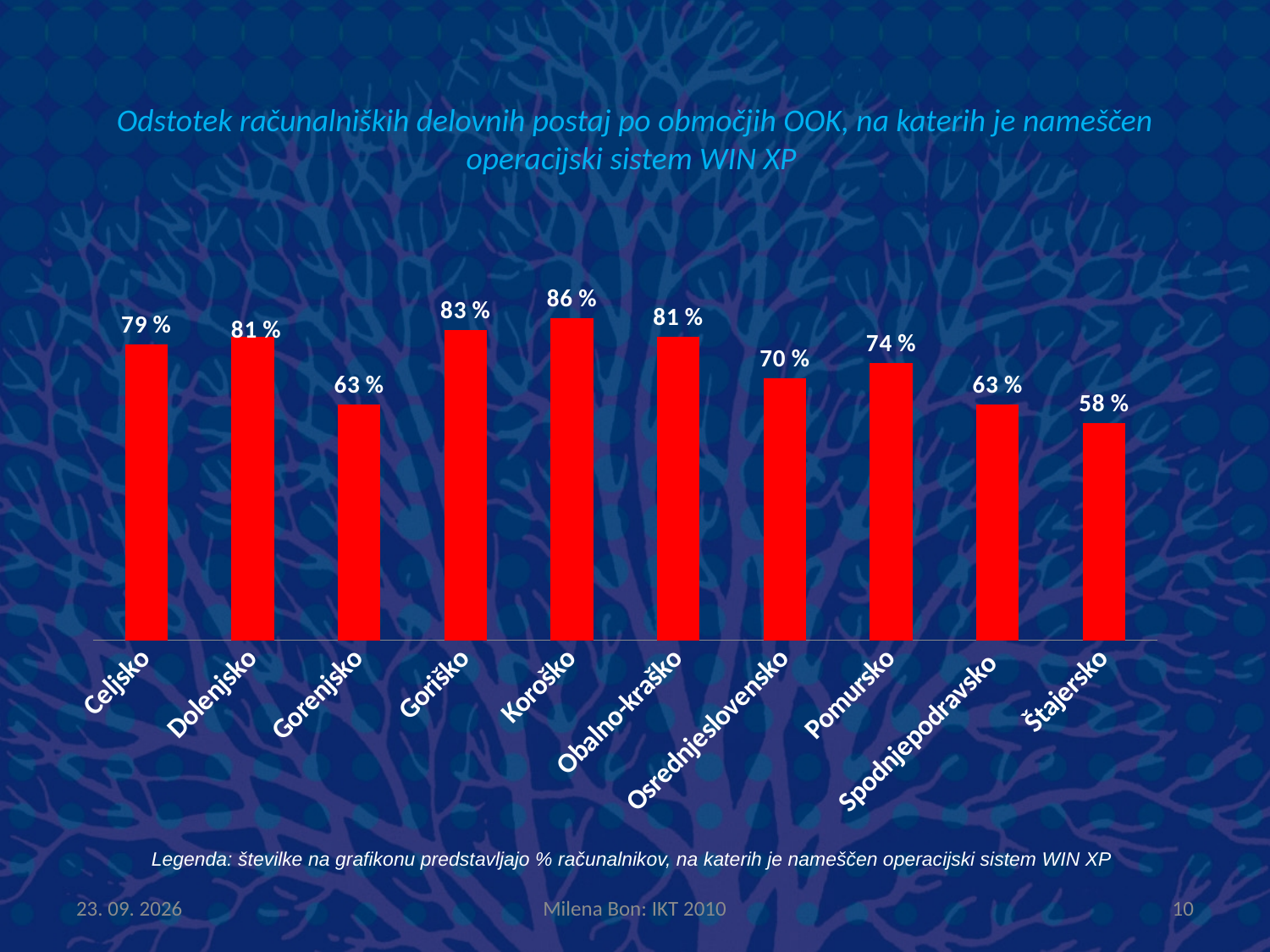
What kind of chart is shown on the slide? Bar chart Which is larger, the value for Celjsko or the value for Gorenjsko? Celjsko Which region has the lowest value? Štajersko What is the value for Koroško? 86 % What is the value for Štajersko? 58 % What colour are the bars in the chart? Red How many regions are shown on the chart? 10 What is the difference between the values for Koroško and Štajersko? 28 % What is the value for Osrednjeslovensko? 70 % What is the difference between the values for Goriško and Pomursko? 9 % Which is larger, the value for Pomursko or the value for Obalno-kraško? Obalno-kraško Which region has the highest value? Koroško